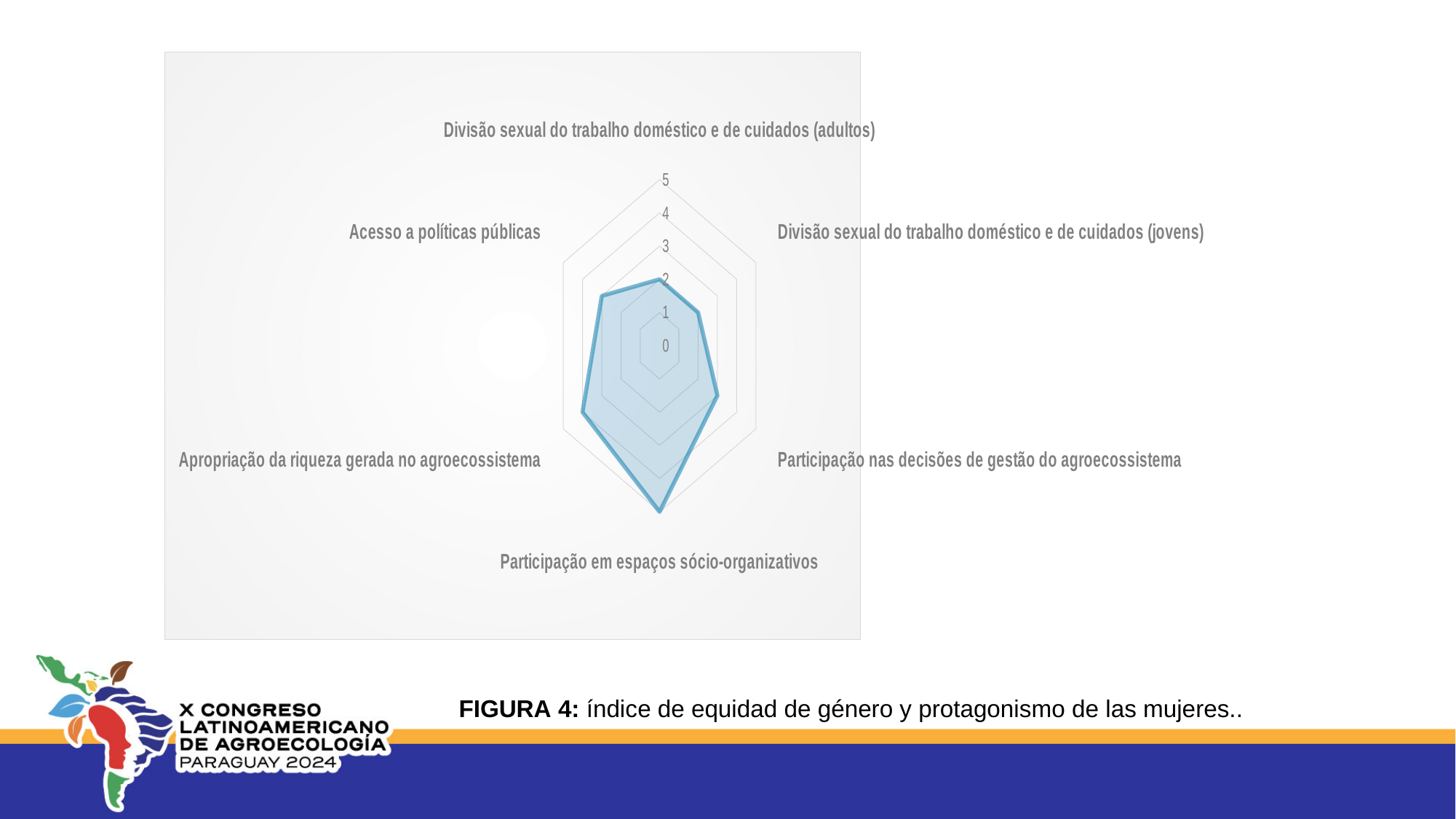
Which category has the highest value on the radar chart? Participação em espaços sócio-organizativos What is the value for Divisão sexual do trabalho doméstico e de cuidados (adultos)? 2 What kind of chart is shown on the slide? Radar chart What is the maximum value shown on the radar chart's scale? 5 Which is larger: the value for Apropriação da riqueza gerada no agroecossistema or the value for Participação nas decisões de gestão do agroecossistema? Apropriação da riqueza gerada no agroecossistema Is the value for Apropriação da riqueza gerada no agroecossistema greater or less than 2? greater What is the value for Participação em espaços sócio-organizativos? 5 How many categories (axes) does the radar chart have? 6 Which category has the lowest value on the radar chart? Divisão sexual do trabalho doméstico e de cuidados (adultos) and Divisão sexual do trabalho doméstico e de cuidados (jovens) (tied at 2) What is the figure caption below the chart? FIGURA 4: índice de equidad de género y protagonismo de las mujeres..